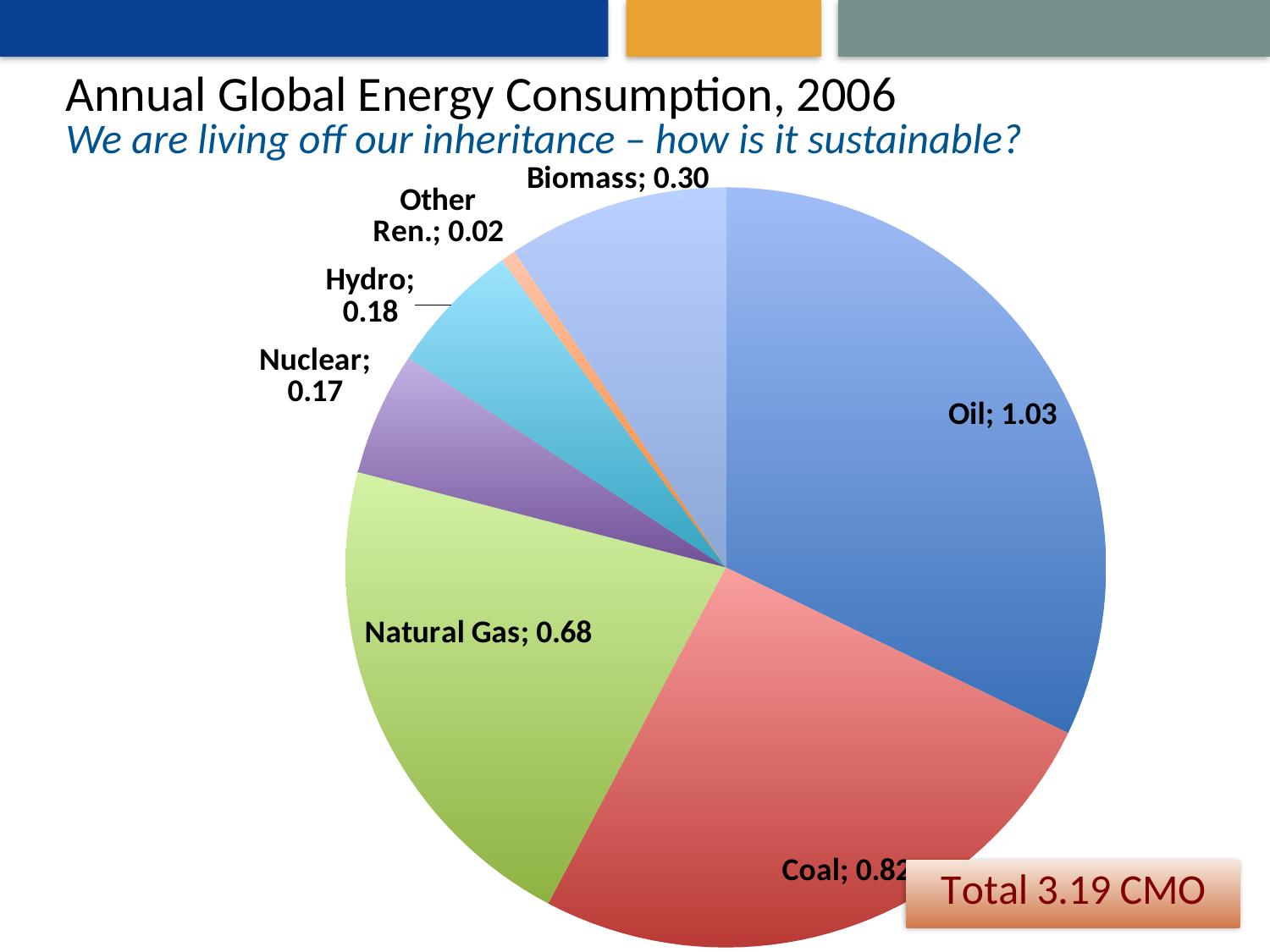
What kind of chart is shown on the slide? Pie chart What is the value for Oil in the pie chart? 1.03 What is the value for Nuclear in the pie chart? 0.17 Which energy source has the smallest slice of the pie chart? Other Ren. What is the value for Other Ren. in the pie chart? 0.02 What is the value for Natural Gas in the pie chart? 0.68 What is the value for Hydro in the pie chart? 0.18 How many energy source categories are shown in the pie chart? 7 What is the value for Biomass in the pie chart? 0.30 Which energy source has the largest slice of the pie chart? Oil What is the difference between the values for Oil and Natural Gas? 0.35 Which is larger, the value for Hydro or the value for Nuclear? Hydro